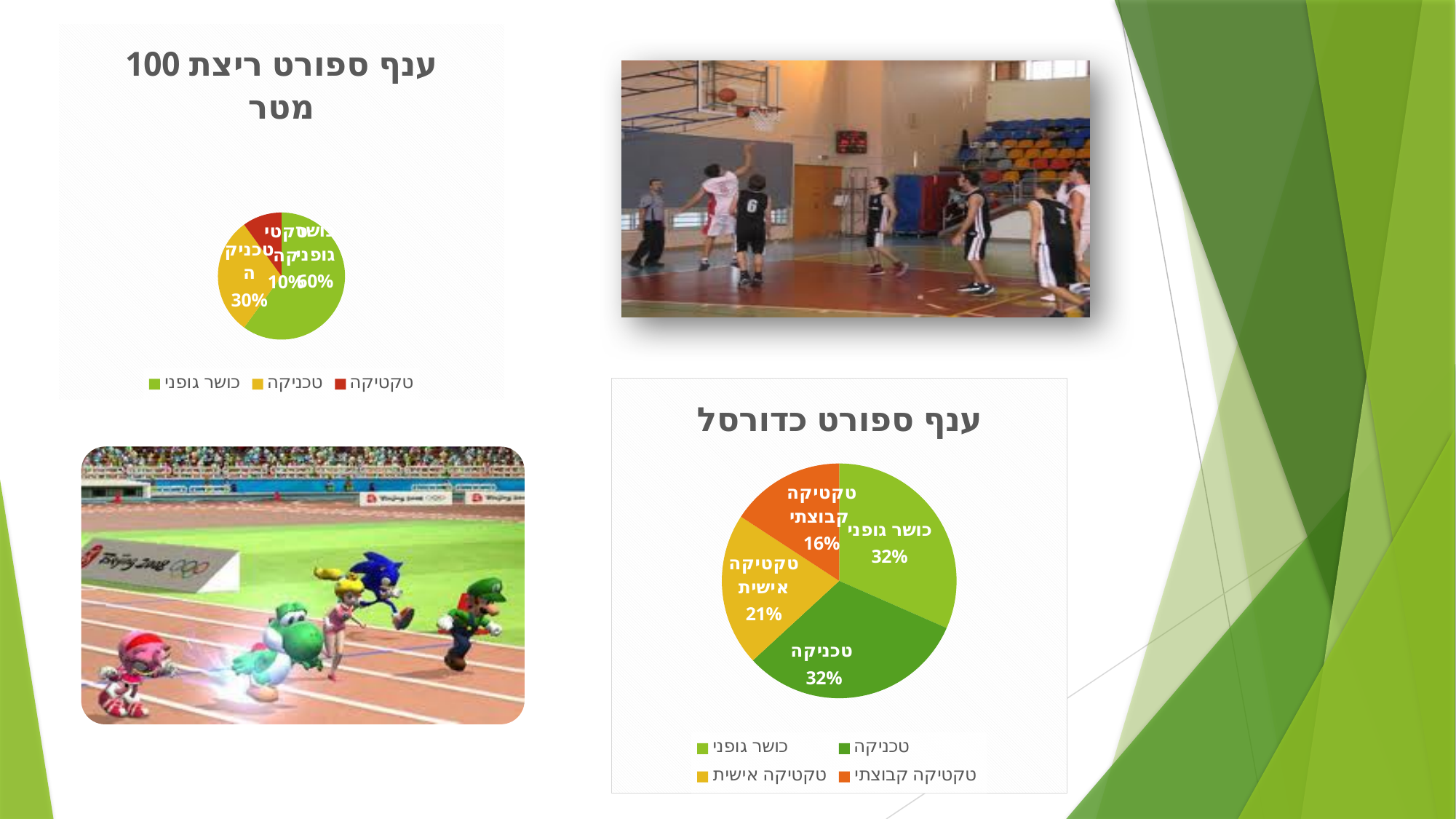
In the chart titled "ענף ספורט ריצת 100 מטר", how many slices does the pie have? 3 In the chart titled "ענף ספורט כדורסל", which category has the smallest slice? טקטיקה קבוצתי In the chart titled "ענף ספורט ריצת 100 מטר", which is larger, טכניקה or טקטיקה? טכניקה In the chart titled "ענף ספורט ריצת 100 מטר", what percentage is shown for טכניקה? 30% In the chart titled "ענף ספורט כדורסל", what percentage is shown for טקטיקה אישית? 21% In the chart titled "ענף ספורט כדורסל", what is the difference in percentage points between טקטיקה אישית and טקטיקה קבוצתי? 5 In the chart titled "ענף ספורט כדורסל", what percentage is shown for כושר גופני? 32% In the chart titled "ענף ספורט ריצת 100 מטר", what percentage is shown for כושר גופני? 60% What kind of chart is the chart titled "ענף ספורט כדורסל"? pie chart In the chart titled "ענף ספורט כדורסל", what percentage is shown for טקטיקה קבוצתי? 16% In the chart titled "ענף ספורט ריצת 100 מטר", which category has the largest slice? כושר גופני In the chart titled "ענף ספורט כדורסל", how many categories does the legend list? 4